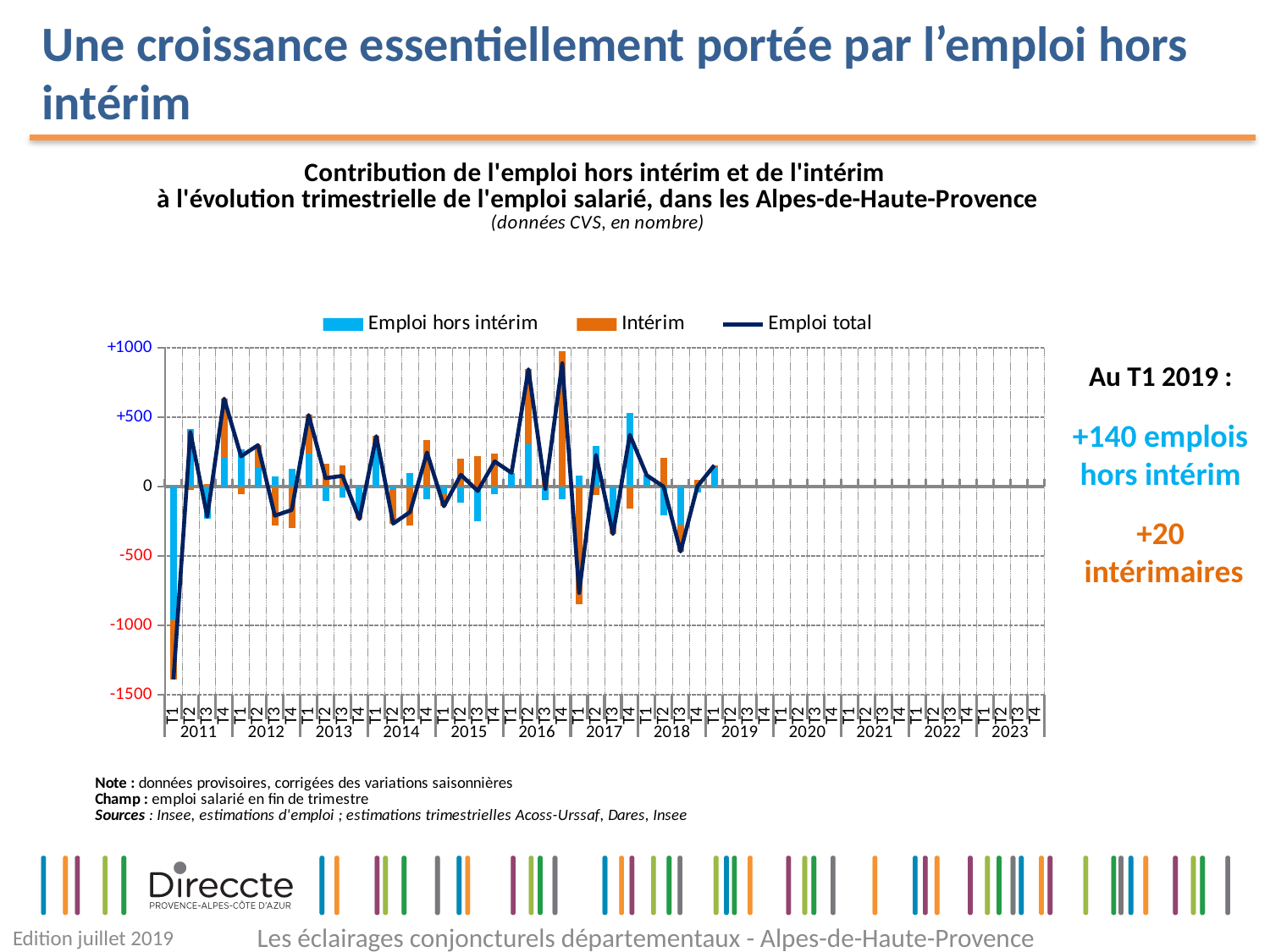
According to the slide, what is the value for Intérim at T1 2019? +20 How many years are labelled along the x axis of the chart? 13 What kind of chart is shown on the slide? A combined bar and line chart Which series is drawn as a line in the chart? Emploi total Is the value for Intérim at T4 2016 greater or less than +500? greater At T1 2019, which is larger: Emploi hors intérim or Intérim? Emploi hors intérim What is the difference between the Emploi hors intérim value (+140) and the Intérim value (+20) at T1 2019? 120 In which quarter does the Emploi total line reach its lowest value? T1 2011 Is the value for Emploi total at T1 2017 greater or less than -500? less According to the slide, what is the value for Emploi hors intérim at T1 2019? +140 How many series does the chart legend list? 3